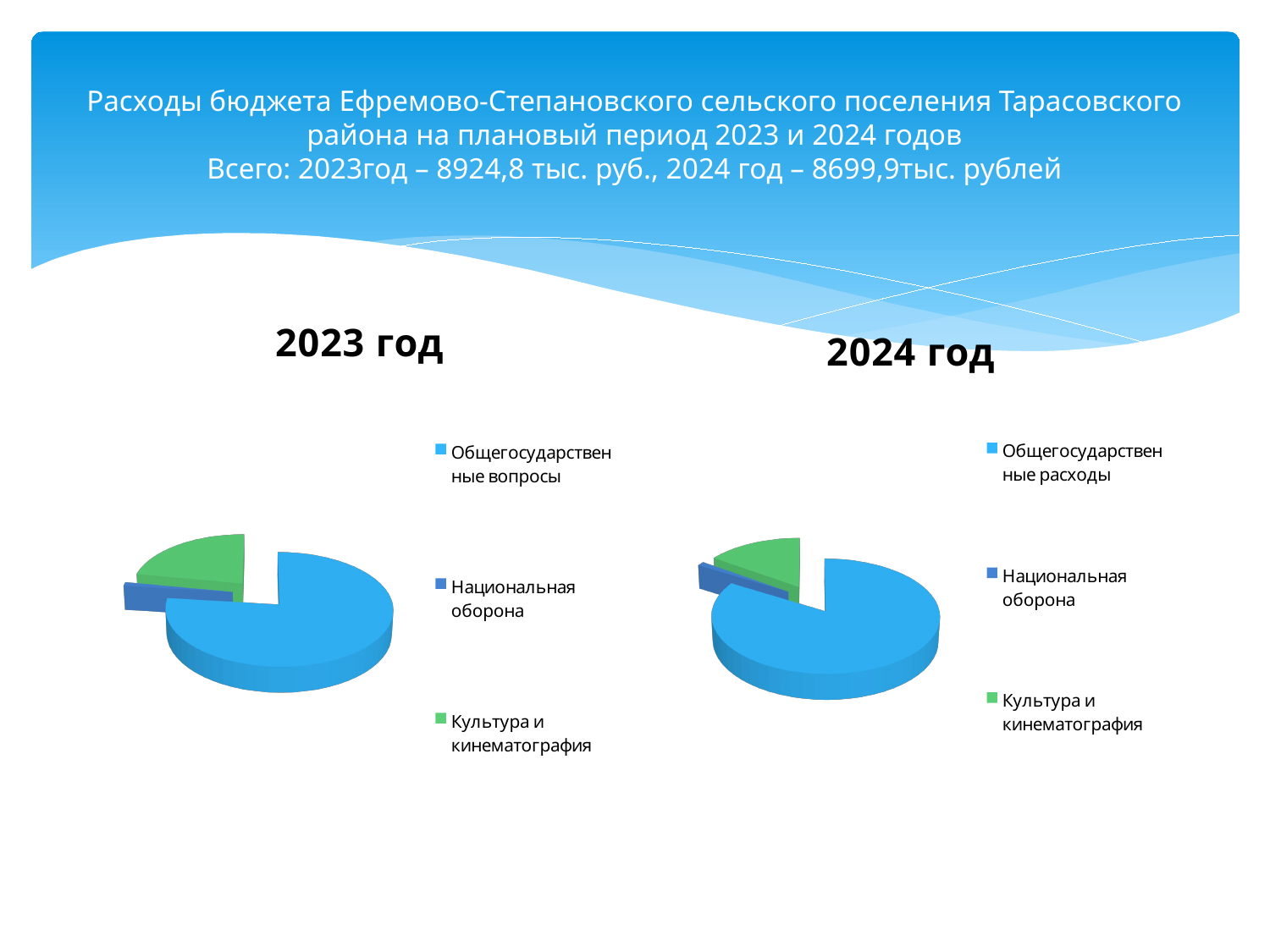
In the "2023 год" chart, which category has the smallest slice? Национальная оборона In the "2023 год" chart, how many categories does the legend list? 3 In the "2023 год" chart, which category has the largest slice? Общегосударственные вопросы In the "2023 год" chart, which slice is larger: Культура и кинематография or Национальная оборона? Культура и кинематография In the "2024 год" chart, how many slices does the pie have? 3 In the "2024 год" chart, which category has the smallest slice? Национальная оборона In the "2023 год" chart, what colour is the slice for Культура и кинематография? green In the "2024 год" chart, which slice is larger: Общегосударственные расходы or Культура и кинематография? Общегосударственные расходы In the "2024 год" chart, what is the first legend entry? Общегосударственные расходы What kind of chart is the "2024 год" chart? pie chart What kind of chart is the "2023 год" chart? pie chart In the "2024 год" chart, which category has the largest slice? Общегосударственные расходы